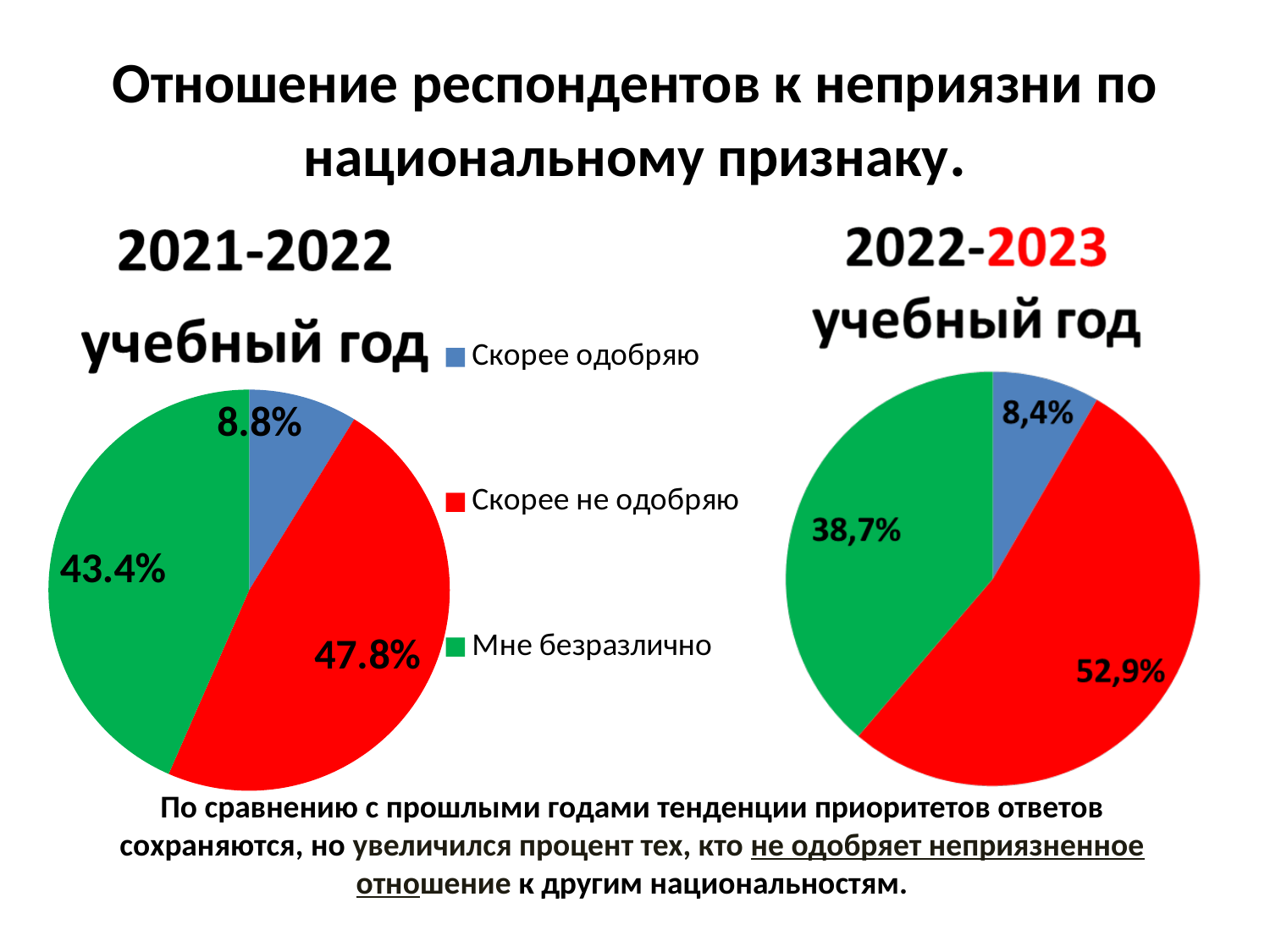
What type of chart is used for the 2021-2022 учебный год data? Pie chart In the 2022-2023 учебный год pie chart, which category has the smallest slice? Скорее одобряю In the 2021-2022 учебный год pie chart, what share is labelled for the 'Скорее не одобряю' slice? 47.8% In the 2022-2023 учебный год pie chart, what share is labelled for the 'Скорее не одобряю' slice? 52,9% In the 2021-2022 учебный год pie chart, which is larger: 'Скорее не одобряю' or 'Мне безразлично'? Скорее не одобряю In the 2021-2022 учебный год pie chart, which category has the largest slice? Скорее не одобряю Which colour represents 'Мне безразлично' in the legend? Green How many slices does the 2022-2023 учебный год pie chart have? 3 In the 2022-2023 учебный год pie chart, what is the difference between the 'Скорее не одобряю' and 'Мне безразлично' shares? 14,2% In the 2022-2023 учебный год pie chart, what share is labelled for the 'Мне безразлично' slice? 38,7% In the 2022-2023 учебный год pie chart, what share is labelled for the 'Скорее одобряю' slice? 8,4% In the 2021-2022 учебный год pie chart, what share is labelled for the 'Мне безразлично' slice? 43.4%